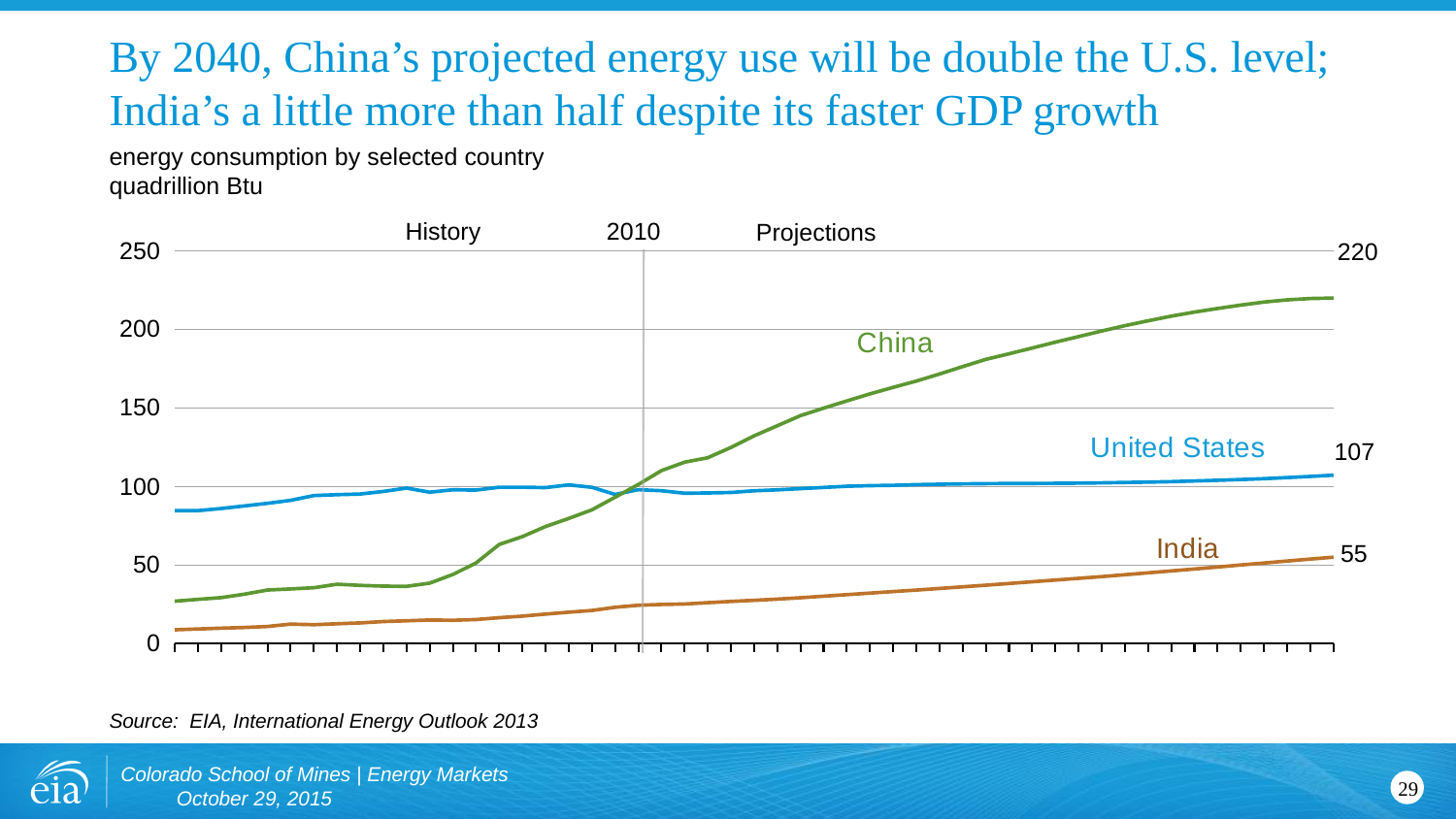
Which country has the lowest energy consumption at the right end of the chart? India What is the final projected value shown for China at the right end of the chart? 220 Which country has the highest energy consumption at the right end of the chart? China What is the difference between the United States' and India's final values shown on the chart? 52 Is the value for India at the 2010 line greater or less than 50? less What is the final projected value shown for India at the right end of the chart? 55 At the right end of the chart, is the value for the United States larger or smaller than the value for India? larger What is the difference between China's and the United States' final values shown on the chart? 113 What is the final projected value shown for the United States at the right end of the chart? 107 Is the value for China at the left end of the chart greater or less than 50? less What type of chart is shown on the slide? line chart How many countries are plotted on the chart? 3